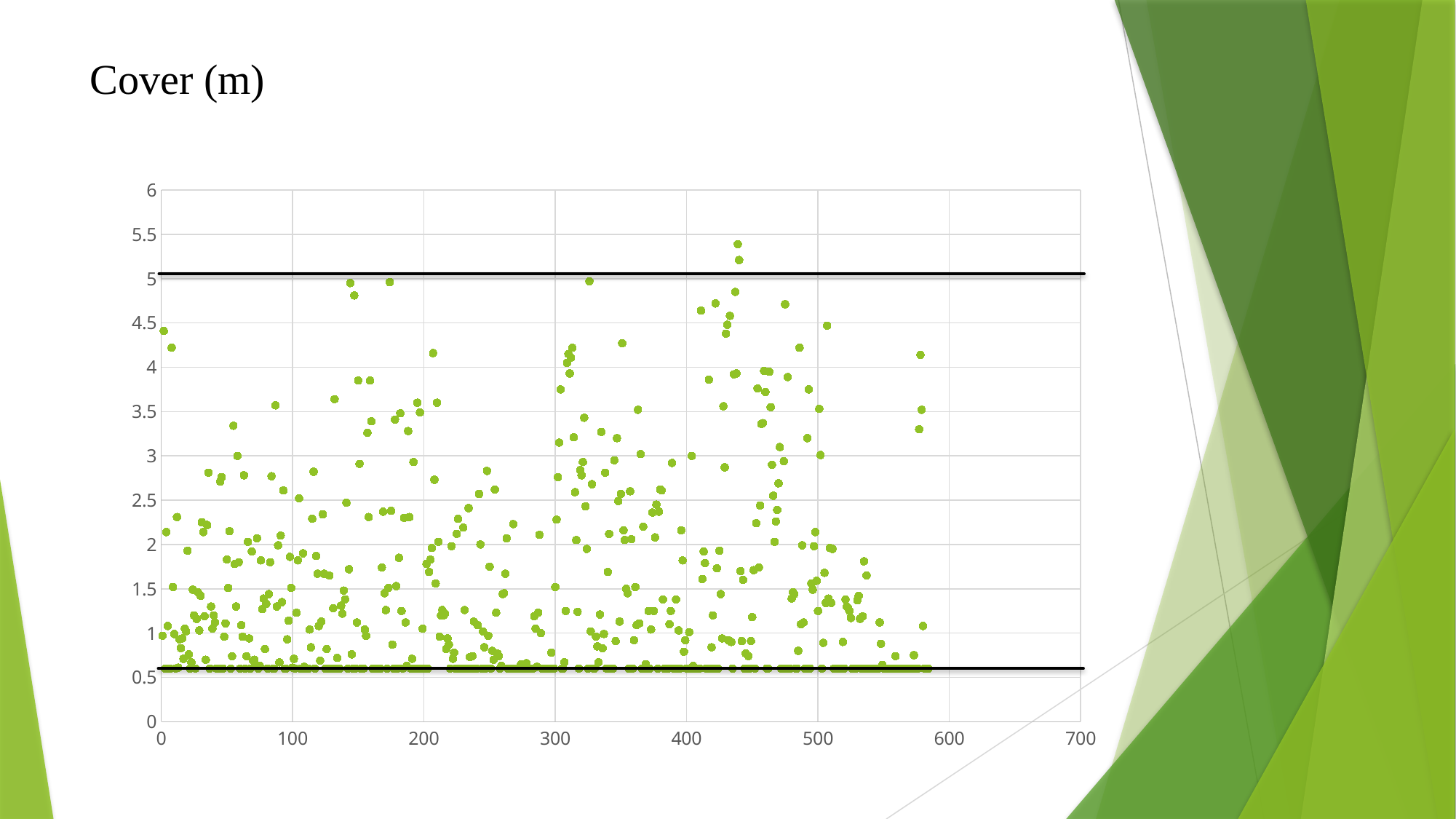
Is the highest plotted point on the chart greater or less than 5 on the y axis? greater Is the largest x value of any plotted point greater or less than 600? less How many horizontal black lines are drawn across the chart? 2 Is the highest plotted point on the chart greater or less than 5.5 on the y axis? less What kind of chart is shown on the slide? Scatter chart What is the title shown above the chart on the slide? Cover (m)